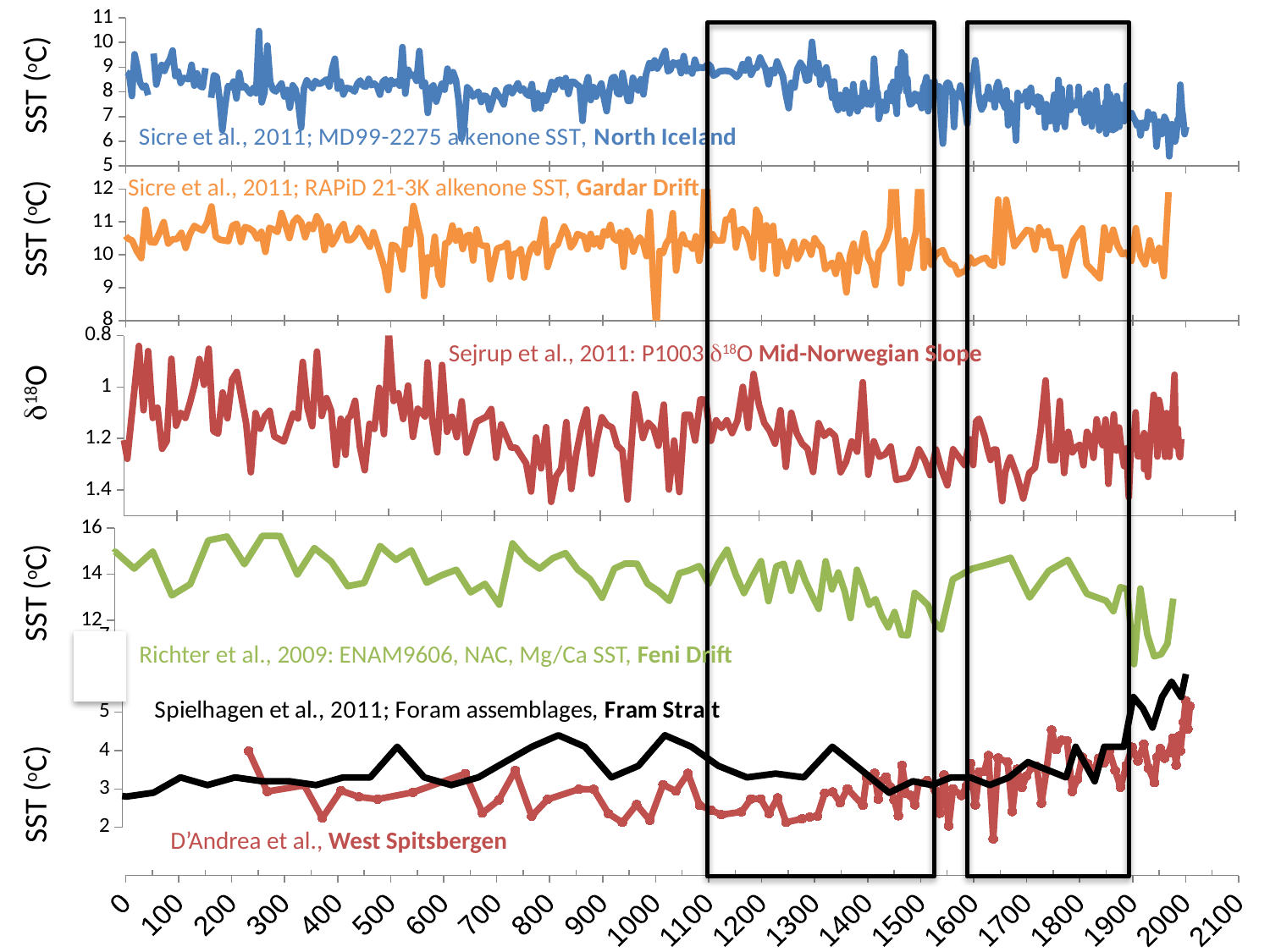
In the bottom panel at year 1000, which series has the larger value: the black Fram Strait series or the red West Spitsbergen series? Fram Strait In the top panel (North Iceland), is the SST value around year 1900 greater or less than 8? less In the top panel (North Iceland alkenone SST), does the SST overall rise or fall from year 0 to year 2000? fall In the bottom panel (Fram Strait / West Spitsbergen), how many series are plotted? 2 In the bottom panel, does the black Fram Strait series rise or fall between 1900 and 2000? rise In the top panel (North Iceland), is the SST value at year 0 greater or less than 7? greater In the bottom panel, is the black Fram Strait value at year 2000 greater or less than 5? greater What kind of chart is used for the panels on this slide? line chart Which location does the blue series in the top panel represent? North Iceland What is the y-axis label of the third panel (Sejrup et al., 2011)? δ18O How many stacked chart panels are shown on the slide? 5